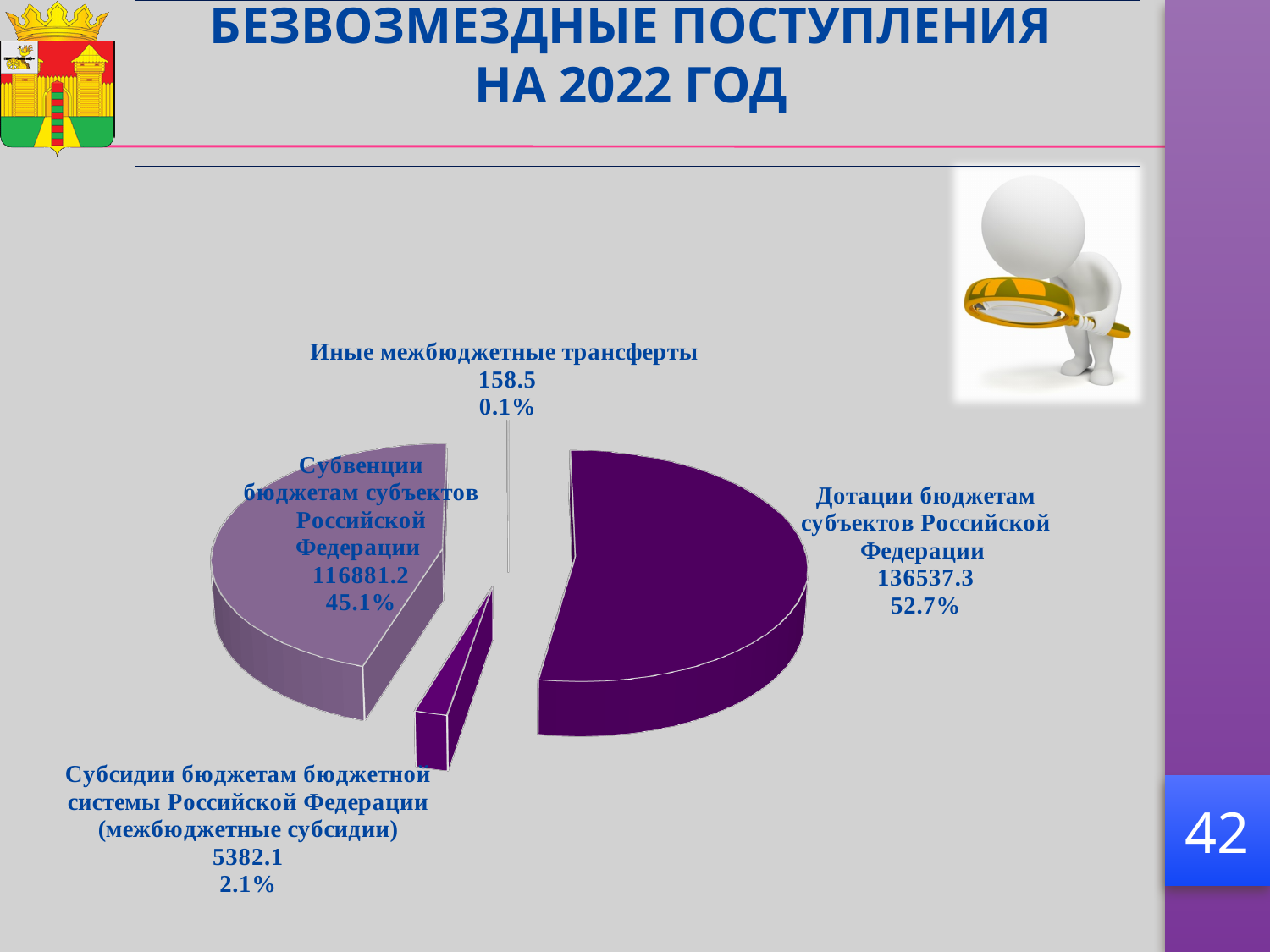
What share of the pie does Субвенции бюджетам субъектов Российской Федерации represent? 45.1% Which category has the smallest slice of the pie? Иные межбюджетные трансферты Which is larger: the value for Субсидии бюджетам бюджетной системы Российской Федерации (межбюджетные субсидии) or Иные межбюджетные трансферты? Субсидии бюджетам бюджетной системы Российской Федерации (межбюджетные субсидии) What is the difference between the values for Дотации бюджетам субъектов Российской Федерации and Субвенции бюджетам субъектов Российской Федерации? 19656.1 What is the value for Дотации бюджетам субъектов Российской Федерации? 136537.3 What is the title of the slide containing the pie chart? БЕЗВОЗМЕЗДНЫЕ ПОСТУПЛЕНИЯ НА 2022 ГОД What kind of chart is shown on the slide? pie chart Which category has the largest slice of the pie? Дотации бюджетам субъектов Российской Федерации What is the value for Субсидии бюджетам бюджетной системы Российской Федерации (межбюджетные субсидии)? 5382.1 What share of the pie does Иные межбюджетные трансферты represent? 0.1% How many slices does the pie chart have? 4 What share of the pie does Дотации бюджетам субъектов Российской Федерации represent? 52.7%